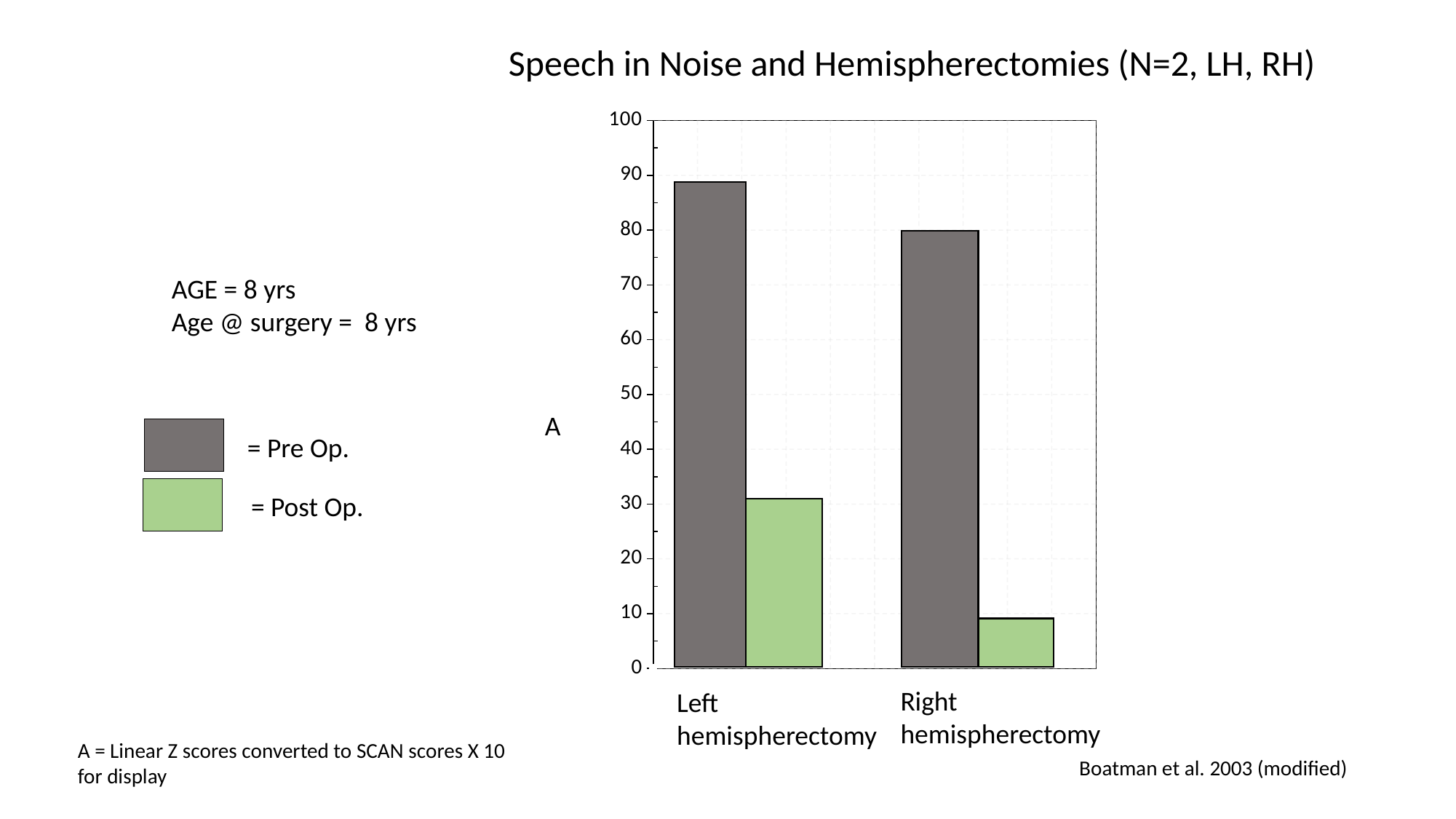
What kind of chart is shown on the slide? bar chart What is the title of the chart? Speech in Noise and Hemispherectomies (N=2, LH, RH) Is the Pre Op. value for Left hemispherectomy greater or less than 80? greater How many series does the legend list? 2 Is the Pre Op. value for Right hemispherectomy greater or less than 70? greater How many categories are shown on the x axis of the chart? 2 Which is larger, the Post Op. value for Left hemispherectomy or the Post Op. value for Right hemispherectomy? Left hemispherectomy Which category has the highest Pre Op. value? Left hemispherectomy Which category has the lowest Post Op. value? Right hemispherectomy Is the Post Op. value for Left hemispherectomy greater or less than 40? less For Left hemispherectomy, which is larger, the Pre Op. value or the Post Op. value? Pre Op.